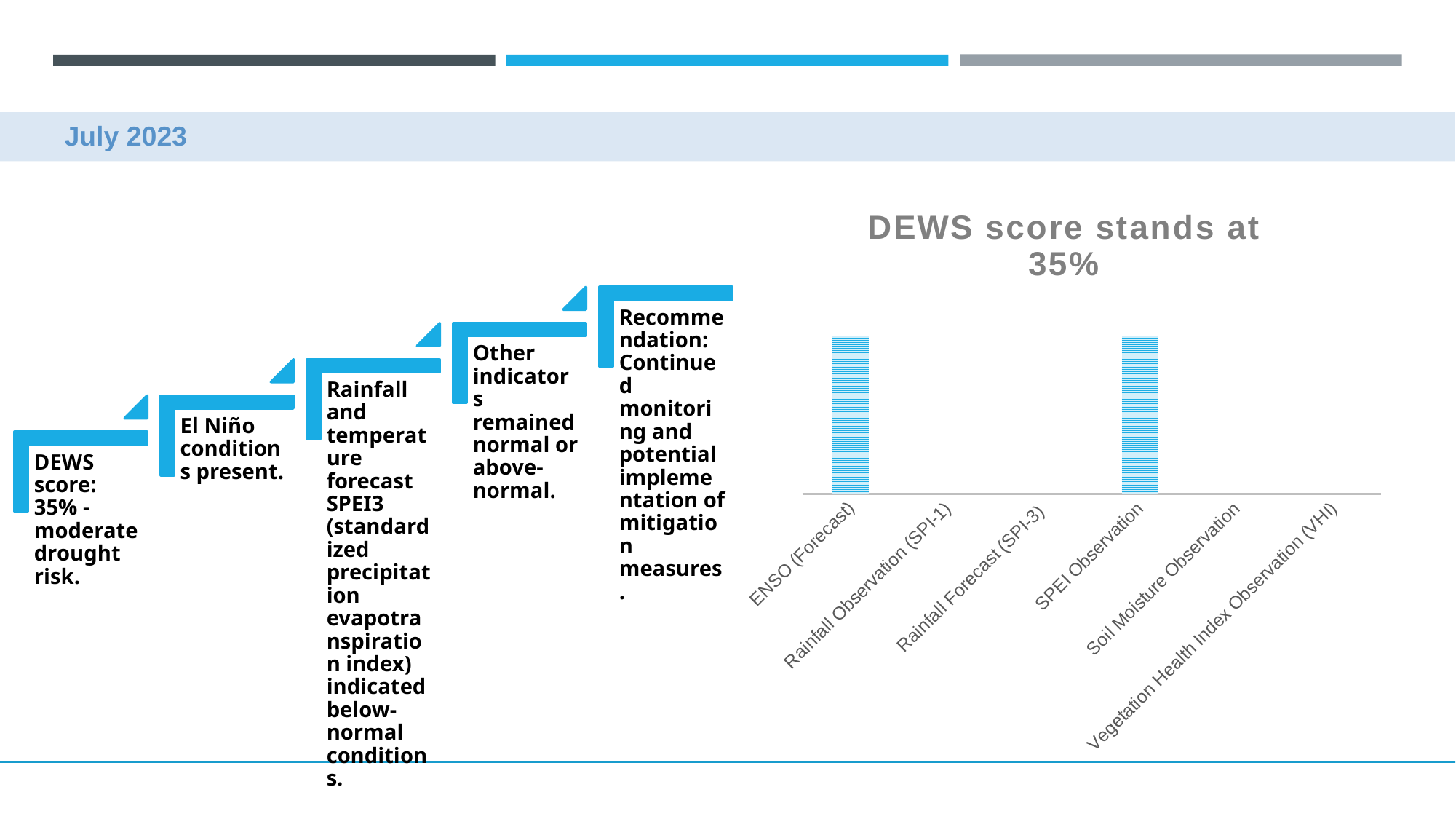
In the chart, is the bar for ENSO (Forecast) larger or smaller than the bar for Rainfall Observation (SPI-1)? larger What kind of chart is shown on the right of the slide? bar chart In the chart, which is larger: ENSO (Forecast) or Vegetation Health Index Observation (VHI)? ENSO (Forecast) Does the chart show a visible bar for Rainfall Forecast (SPI-3)? No What is the title of the chart on the slide? DEWS score stands at 35% What is the last category listed on the x axis of the chart? Vegetation Health Index Observation (VHI) Which two categories in the chart have visible bars? ENSO (Forecast) and SPEI Observation What is the first category listed on the x axis of the chart? ENSO (Forecast) How many categories are shown on the x axis of the chart? 6